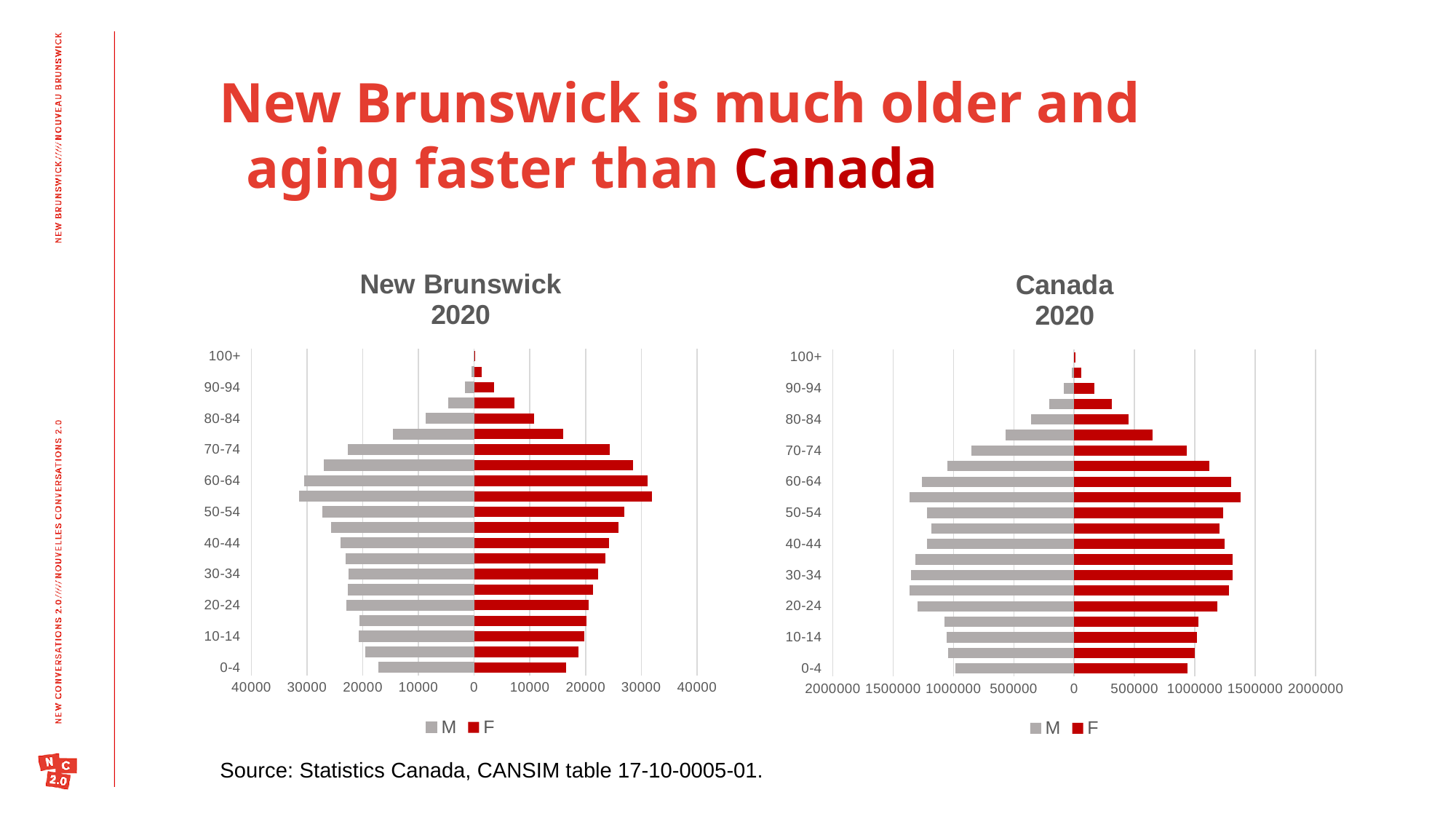
On the Canada 2020 chart, is the F value for the 60-64 age group greater or less than 1000000? greater On the New Brunswick 2020 chart, is the F value for the 60-64 age group greater or less than 20000? greater How many series does the legend of the Canada 2020 chart list? 2 On the New Brunswick 2020 chart, is the M value for the 80-84 age group greater or less than 10000? less On the Canada 2020 chart, which colour represents the F series? red What kind of chart is the New Brunswick 2020 chart? bar chart On the Canada 2020 chart, which is larger: the M value for 60-64 or the M value for 80-84? 60-64 On the New Brunswick 2020 chart, which is larger: the F value for 60-64 or the F value for 0-4? 60-64 What are the two legend entries on the New Brunswick 2020 chart? M and F